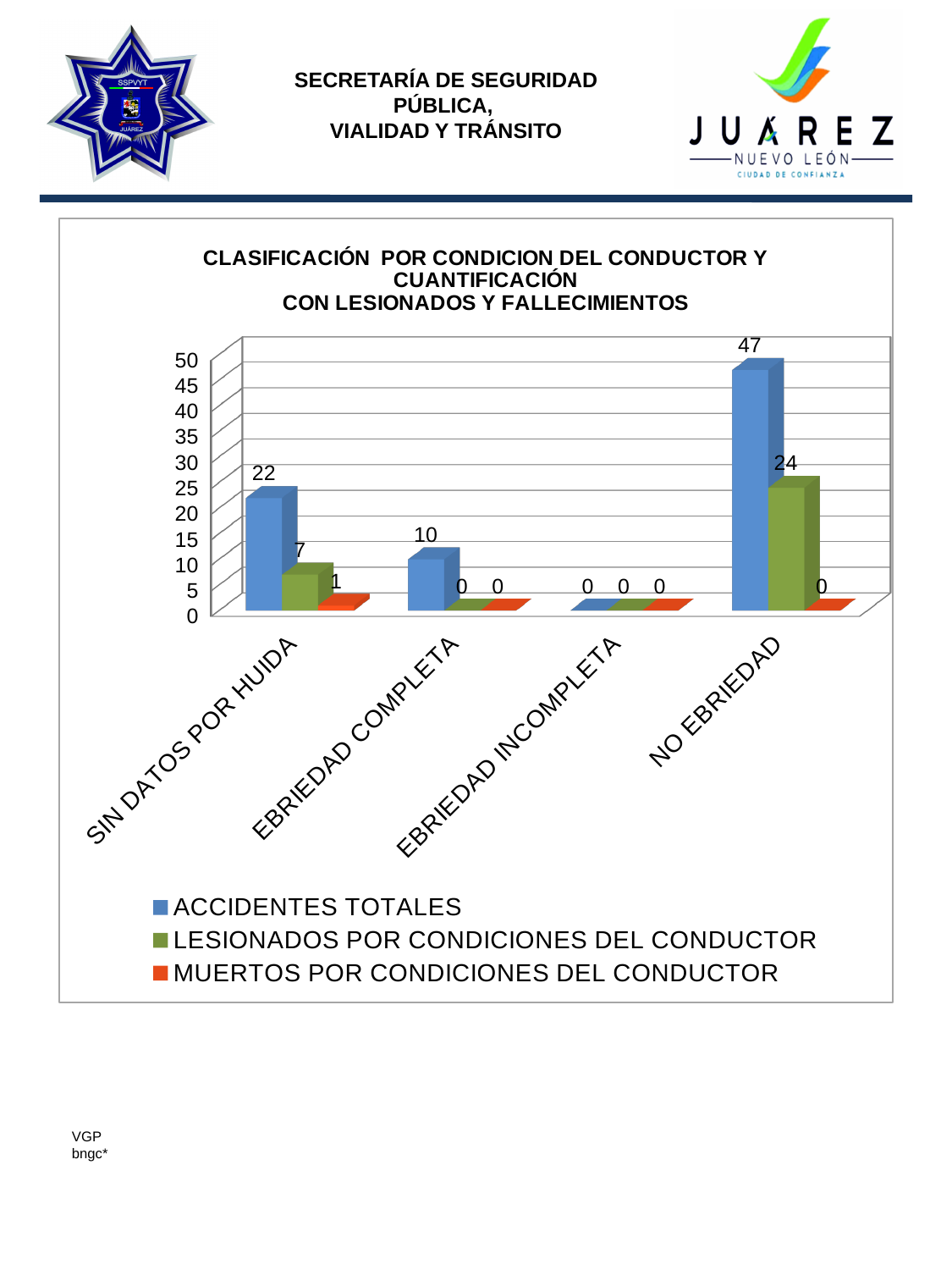
What is the difference between ACCIDENTES TOTALES and LESIONADOS POR CONDICIONES DEL CONDUCTOR for NO EBRIEDAD? 23 Which is larger: ACCIDENTES TOTALES for SIN DATOS POR HUIDA or ACCIDENTES TOTALES for EBRIEDAD COMPLETA? SIN DATOS POR HUIDA How many series does the legend list? 3 Which category has the lowest value for ACCIDENTES TOTALES? EBRIEDAD INCOMPLETA What kind of chart is shown on the slide? Bar chart What is the value of LESIONADOS POR CONDICIONES DEL CONDUCTOR for SIN DATOS POR HUIDA? 7 Which category has the highest value for ACCIDENTES TOTALES? NO EBRIEDAD What is the value of ACCIDENTES TOTALES for EBRIEDAD COMPLETA? 10 What is the value of MUERTOS POR CONDICIONES DEL CONDUCTOR for SIN DATOS POR HUIDA? 1 Which colour represents MUERTOS POR CONDICIONES DEL CONDUCTOR in the legend? Orange How many categories are shown on the x axis? 4 What is the value of ACCIDENTES TOTALES for NO EBRIEDAD? 47